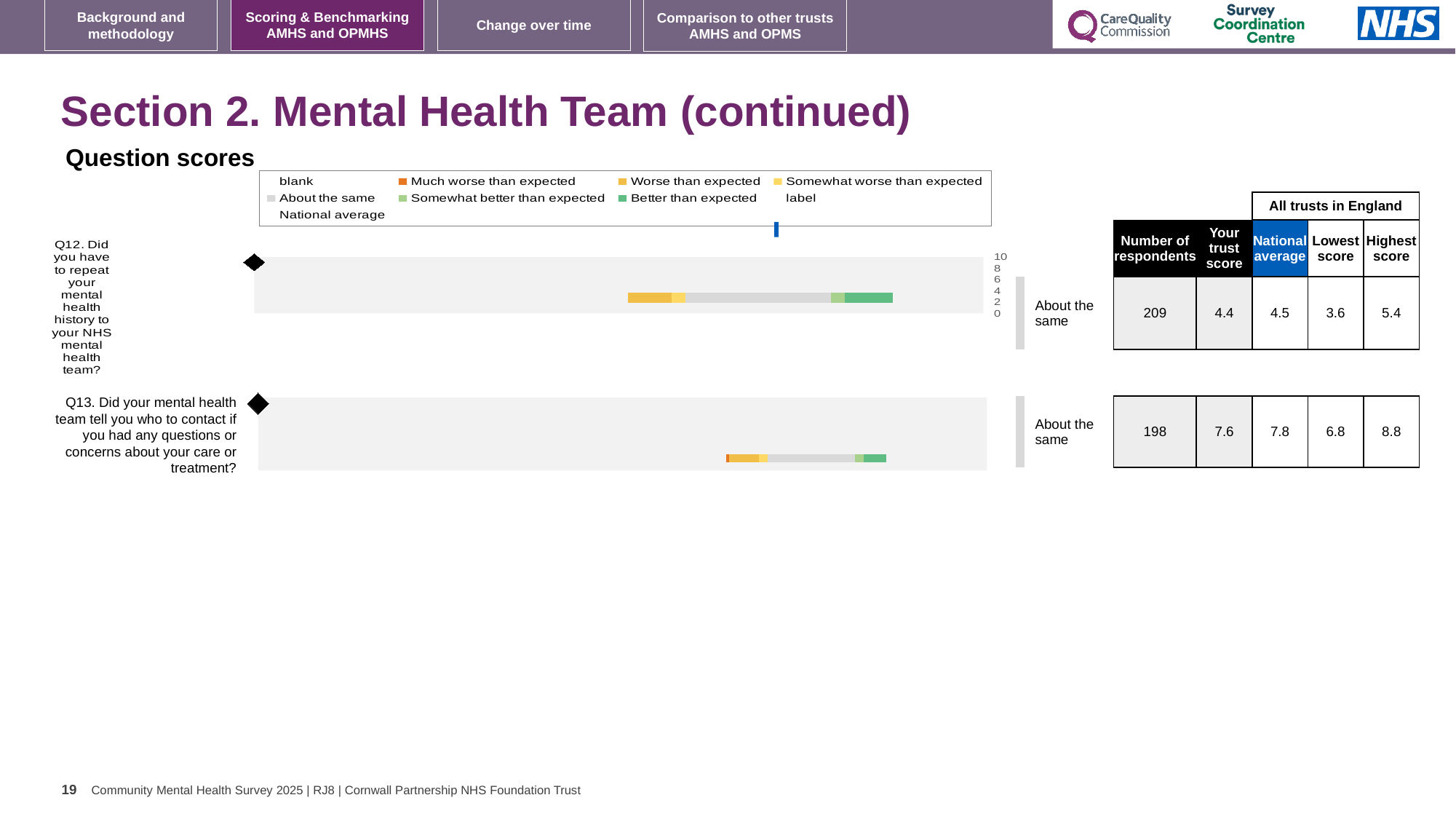
What kind of chart is used to show the question scores for Q12 and Q13? bar chart In the table next to the chart, what is the number of respondents for Q12? 209 In the chart legend, which colour represents 'Much worse than expected'? orange In the table next to the chart, what is the highest score for Q13? 8.8 In the table next to the chart, what is the national average for Q12? 4.5 In the table next to the chart, what is the trust score for Q13? 7.6 Which question has the higher trust score, Q12 or Q13? Q13 What is the difference between the national average and the trust score for Q12? 0.1 In the chart legend, which colour represents 'Better than expected'? green How many questions are plotted in the question scores chart? 2 What is the difference between the highest score and the lowest score for Q13? 2.0 What rating label is shown beside the bar for Q13? About the same